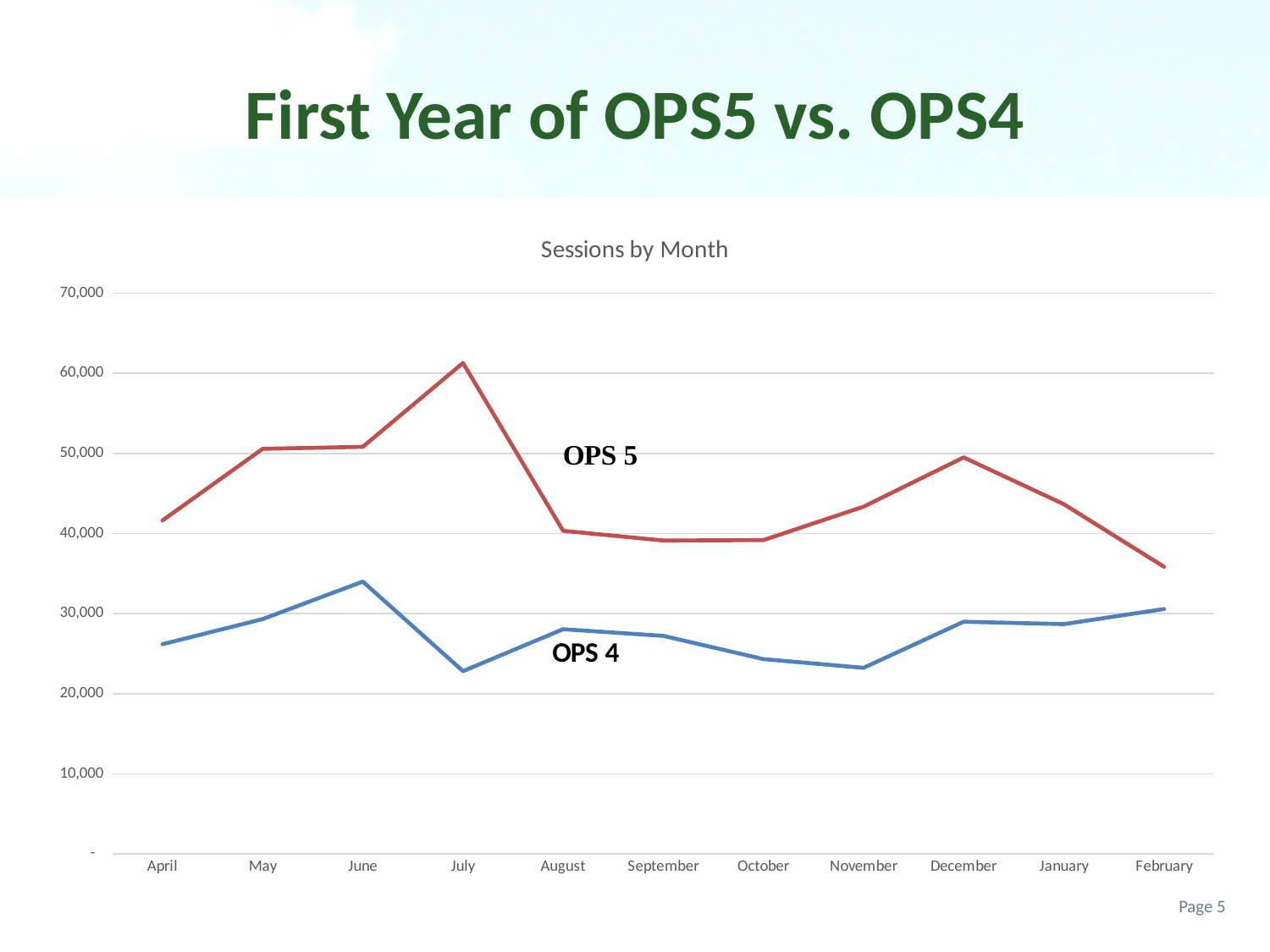
What is the title of the chart? Sessions by Month Does the OPS 5 line rise or fall from July to September? fall What kind of chart is shown on the slide? line chart How many months are plotted along the x axis? 11 In which month does the OPS 4 line reach its lowest value? July In which month does the OPS 5 line reach its lowest value? February Is the OPS 5 value for July greater or less than 50,000? greater Which series has the larger value in December, OPS 5 or OPS 4? OPS 5 In which month does the OPS 5 line reach its highest value? July How many lines (series) are plotted on the chart? 2 Is the OPS 4 value for July greater or less than 30,000? less In which month does the OPS 4 line reach its highest value? June